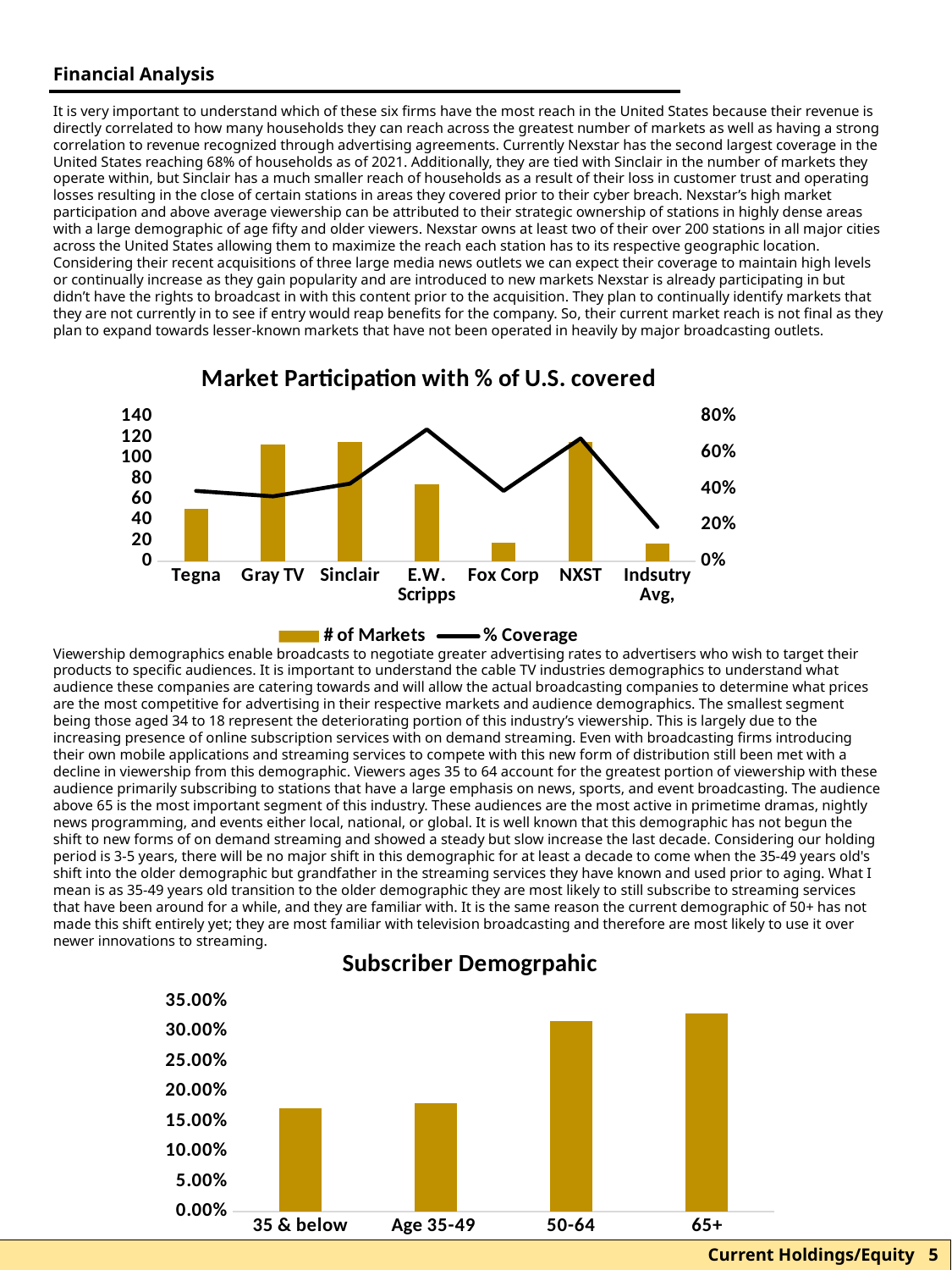
On the 'Market Participation with % of U.S. covered' chart, is the # of Markets for Fox Corp greater or less than 40? less On the 'Market Participation with % of U.S. covered' chart, is the # of Markets for Tegna greater or less than 60? less On the 'Subscriber Demogrpahic' chart, how many categories are shown? 4 On the 'Market Participation with % of U.S. covered' chart, which has more # of Markets, Tegna or Gray TV? Gray TV On the 'Market Participation with % of U.S. covered' chart, how many series does the legend list? 2 What kind of chart is the 'Subscriber Demogrpahic' chart? bar chart On the 'Subscriber Demogrpahic' chart, is the value for 65+ greater or less than 30.00%? greater On the 'Market Participation with % of U.S. covered' chart, how many categories are shown on the x axis? 7 On the 'Market Participation with % of U.S. covered' chart, which category has the lowest % Coverage? Indsutry Avg, On the 'Market Participation with % of U.S. covered' chart, which series is drawn as a line? % Coverage On the 'Subscriber Demogrpahic' chart, which is larger, Age 35-49 or 50-64? 50-64